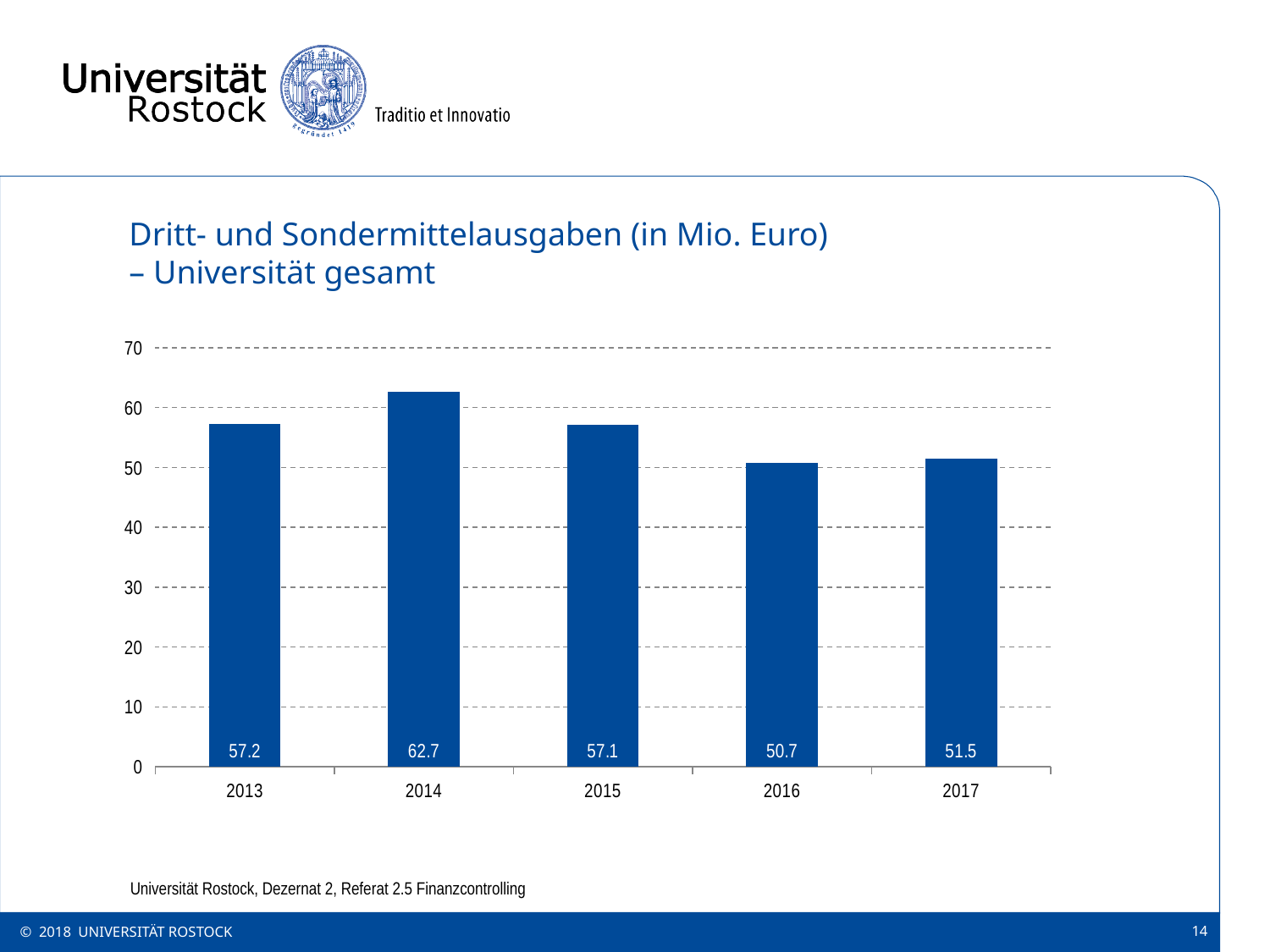
What is the difference between the values for 2013 and 2017? 5.7 Which year has the lowest value? 2016 Which year has the highest value? 2014 What is the value for 2016? 50.7 Which is larger, the value for 2013 or the value for 2017? 2013 Is the value for 2014 greater or less than 60? greater What is the title of the chart? Dritt- und Sondermittelausgaben (in Mio. Euro) – Universität gesamt What kind of chart is shown on the slide? bar chart What is the difference between the values for 2014 and 2016? 12 How many years are shown on the x axis? 5 What is the value for 2017? 51.5 What is the value for 2014? 62.7